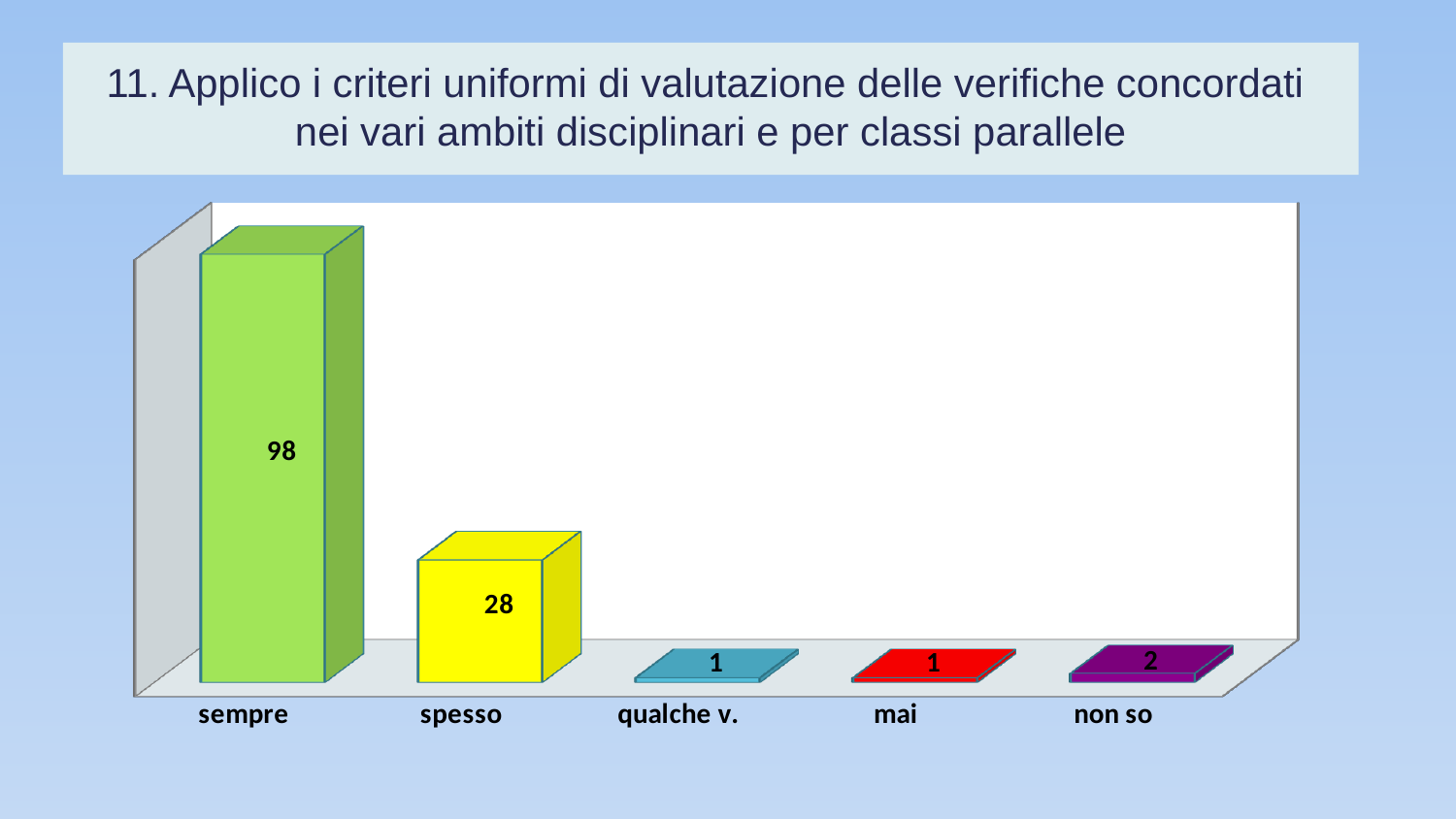
How many categories are shown on the x axis? 5 Which is larger, the value for "spesso" or the value for "non so"? spesso What is the label of the category with the red bar? mai What is the value for "non so"? 2 What is the value for "qualche v."? 1 What is the difference between the values for "sempre" and "spesso"? 70 Which category has the highest value? sempre What is the difference between the values for "non so" and "mai"? 1 What is the value for "spesso"? 28 What kind of chart is shown on the slide? bar chart What colour is the bar for "spesso"? yellow What is the value for "sempre"? 98